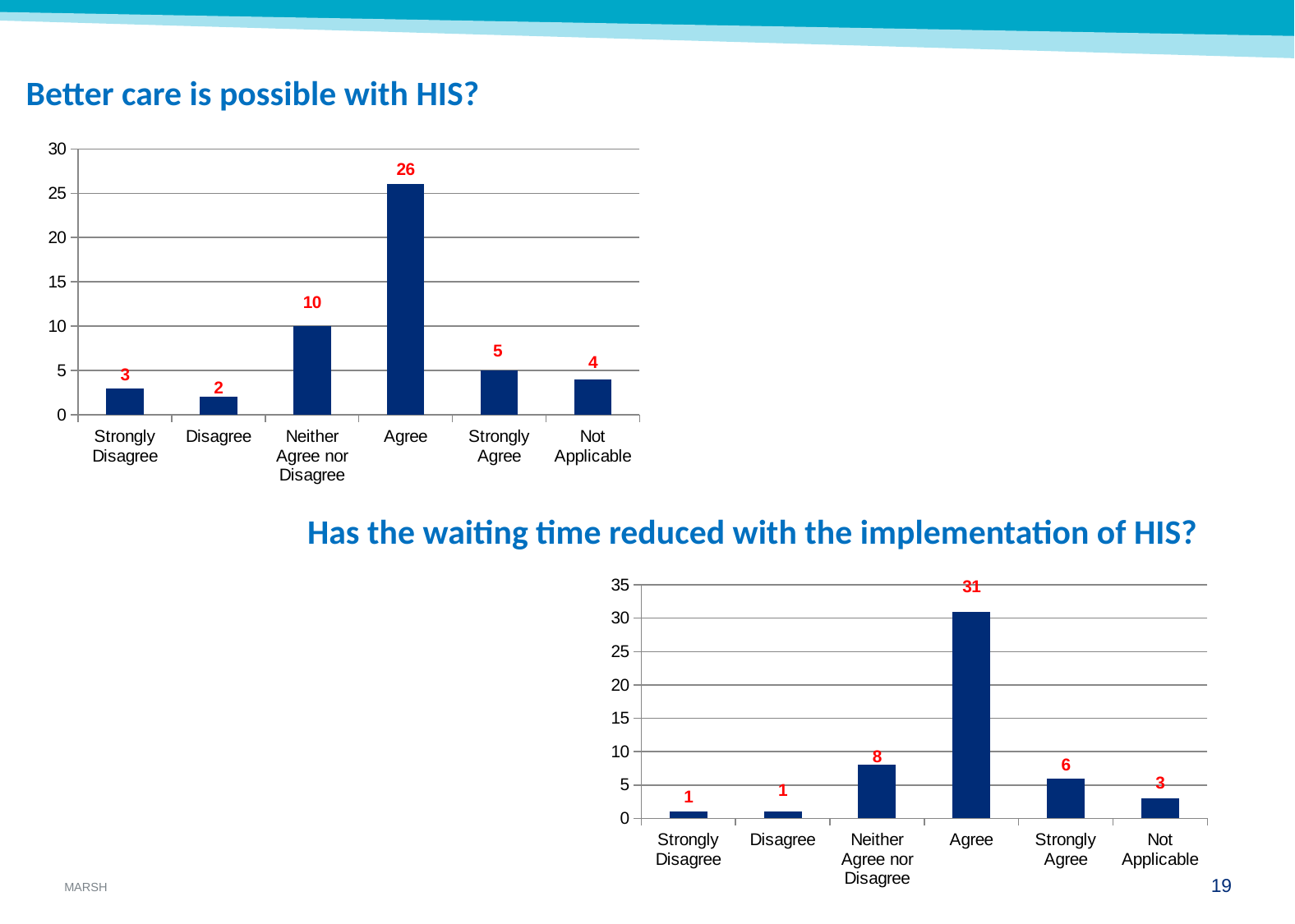
In the 'Has the waiting time reduced with the implementation of HIS?' chart, is the value for Agree greater or less than 30? greater In the 'Better care is possible with HIS?' chart, how many categories are shown on the x axis? 6 In the 'Has the waiting time reduced with the implementation of HIS?' chart, which category has the highest value? Agree In the 'Has the waiting time reduced with the implementation of HIS?' chart, which is larger, Neither Agree nor Disagree or Strongly Agree? Neither Agree nor Disagree In the 'Has the waiting time reduced with the implementation of HIS?' chart, what is the value for Agree? 31 In the 'Has the waiting time reduced with the implementation of HIS?' chart, what is the value for Not Applicable? 3 What kind of chart is the 'Better care is possible with HIS?' chart? Bar chart In the 'Better care is possible with HIS?' chart, what is the value for Neither Agree nor Disagree? 10 In the 'Better care is possible with HIS?' chart, what is the value for Agree? 26 In the 'Better care is possible with HIS?' chart, what is the difference between Agree and Strongly Agree? 21 In the 'Better care is possible with HIS?' chart, which category has the lowest value? Disagree In the 'Has the waiting time reduced with the implementation of HIS?' chart, what is the difference between Agree and Neither Agree nor Disagree? 23